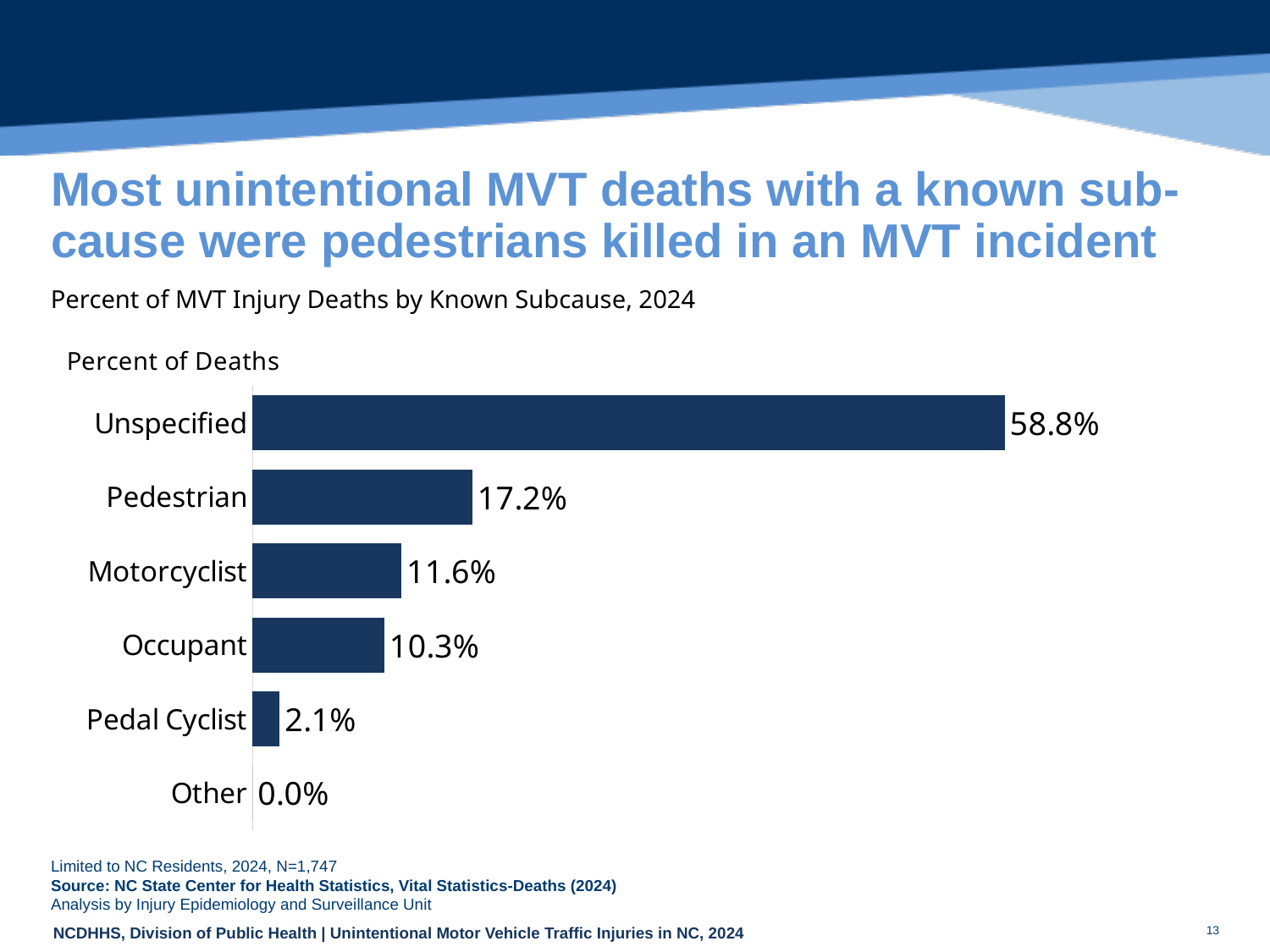
What is the value for Pedal Cyclist? 2.1% Which category has the highest value? Unspecified How many categories are shown in the chart? 6 What is the value for Occupant? 10.3% What is the axis label shown above the bars? Percent of Deaths What is the difference between the values for Unspecified and Pedestrian? 41.6% Which is larger, the value for Pedestrian or the value for Motorcyclist? Pedestrian What kind of chart is shown on the slide? Bar chart What is the value for Motorcyclist? 11.6% What is the value for Pedestrian? 17.2% Which category has the lowest value? Other What is the difference between the values for Motorcyclist and Occupant? 1.3%